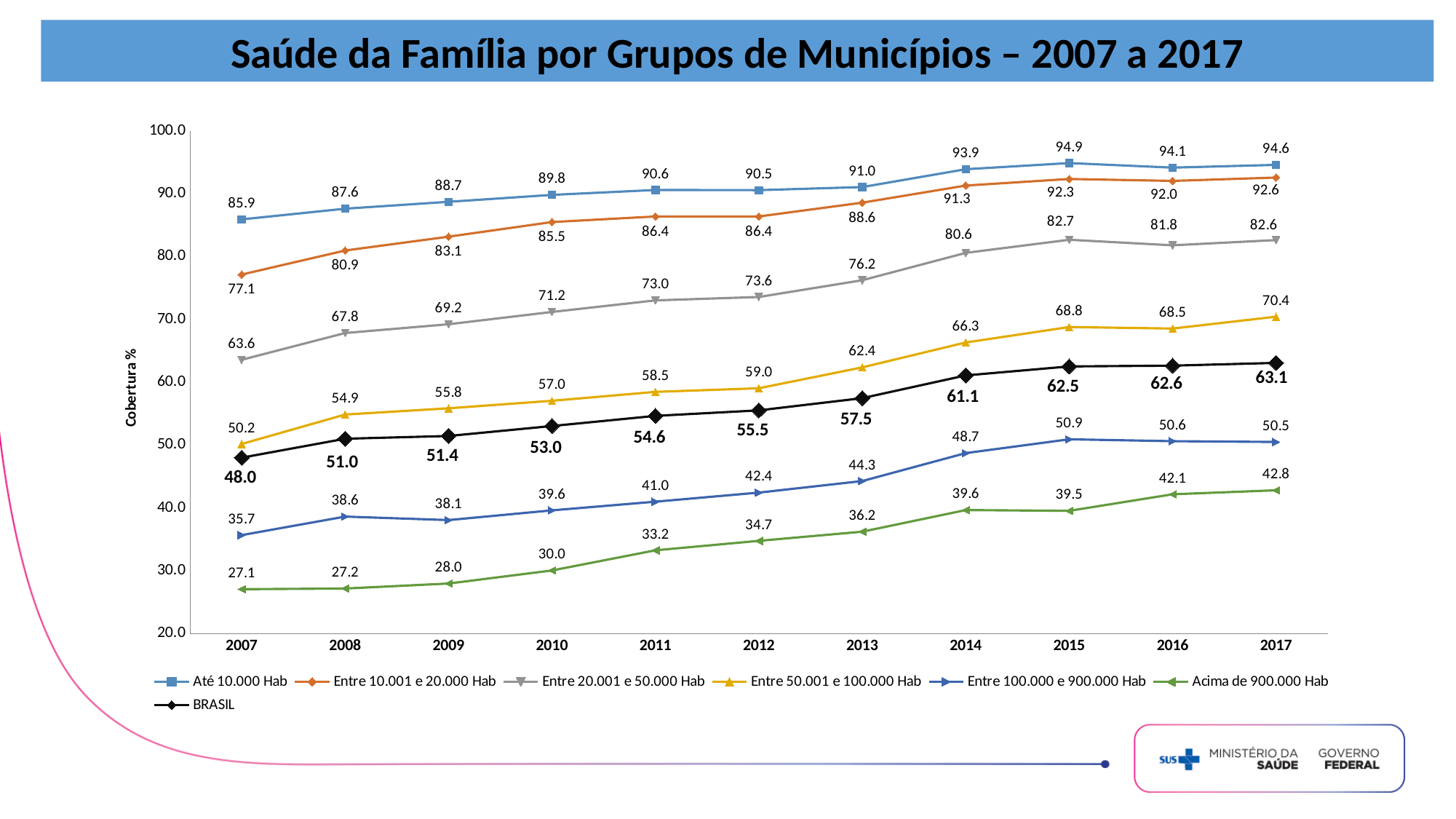
What is the difference between the 'Até 10.000 Hab' and 'Entre 10.001 e 20.000 Hab' values in 2017? 2.0 What is the value for the 'Até 10.000 Hab' series in 2007? 85.9 What kind of chart is shown on the slide? Line chart What is the value for the 'Entre 20.001 e 50.000 Hab' series in 2013? 76.2 In which year is the 'Acima de 900.000 Hab' series at its lowest value? 2007 How many series does the legend list? 7 How many years are shown on the x axis? 11 What is the value for BRASIL in 2017? 63.1 In 2012, which is larger: the value for 'Entre 50.001 e 100.000 Hab' or for 'Entre 100.000 e 900.000 Hab'? Entre 50.001 e 100.000 Hab Does the 'Acima de 900.000 Hab' series generally rise or fall from 2007 to 2017? Rise By how much did the BRASIL value increase from 2007 to 2017? 15.1 In which year does the 'Até 10.000 Hab' series reach its highest value? 2015